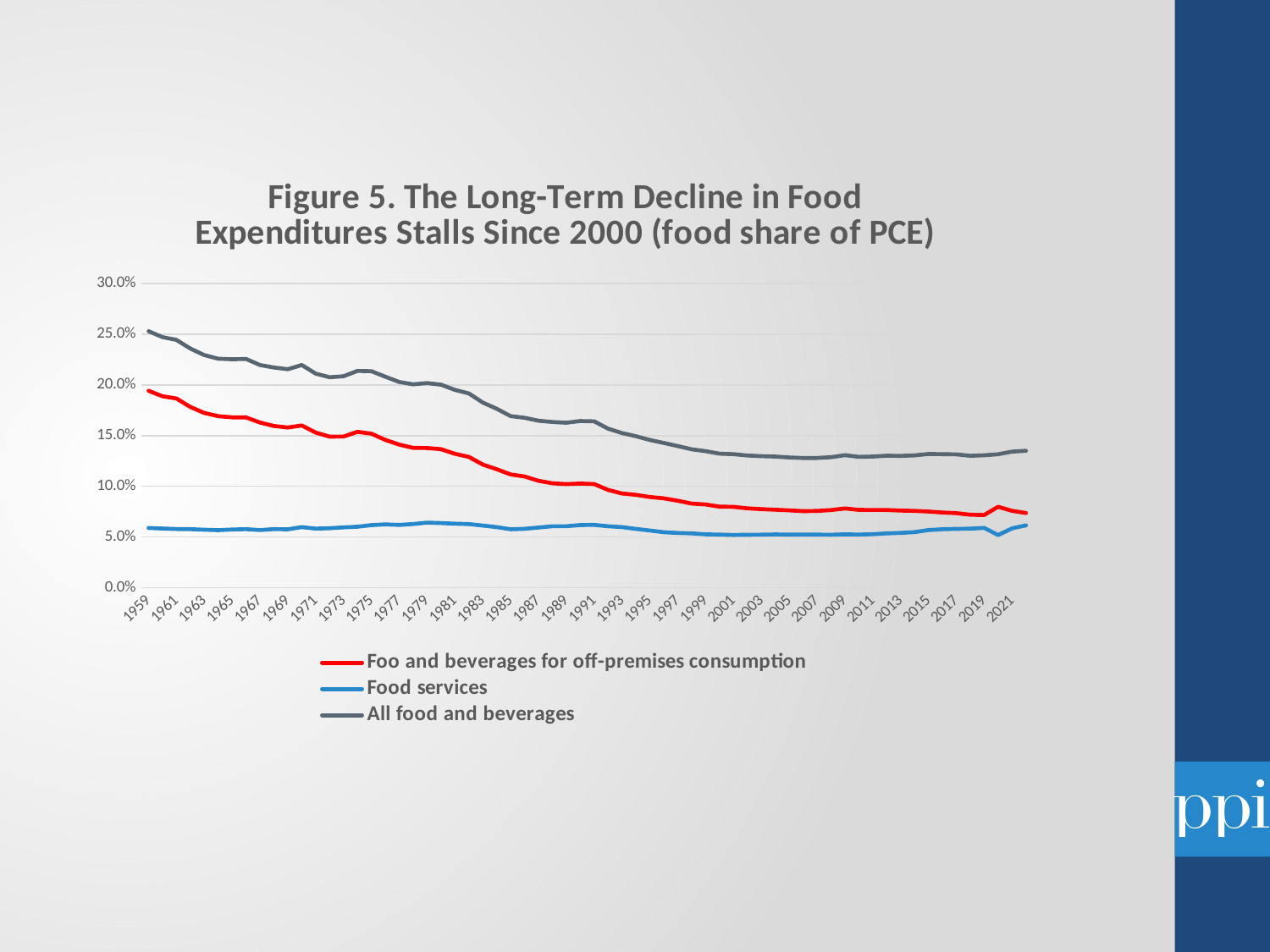
Does the value for Foo and beverages for off-premises consumption rise or fall from 1959 to 2021? fall Is the value for Food services in 1959 greater or less than 10.0%? less Which series has the highest values across the whole chart? All food and beverages Does the value for All food and beverages rise or fall from 1959 to 2021? fall In 1959, which is larger: Foo and beverages for off-premises consumption or Food services? Foo and beverages for off-premises consumption Which series has the lowest values across the whole chart? Food services What kind of chart is shown on the slide? line chart Is the value for Foo and beverages for off-premises consumption in 1959 greater or less than 15.0%? greater What is the title of the chart? Figure 5. The Long-Term Decline in Food Expenditures Stalls Since 2000 (food share of PCE) Is the value for All food and beverages in 2021 greater or less than 15.0%? less What colour is the line for Food services? blue How many series does the legend list? 3